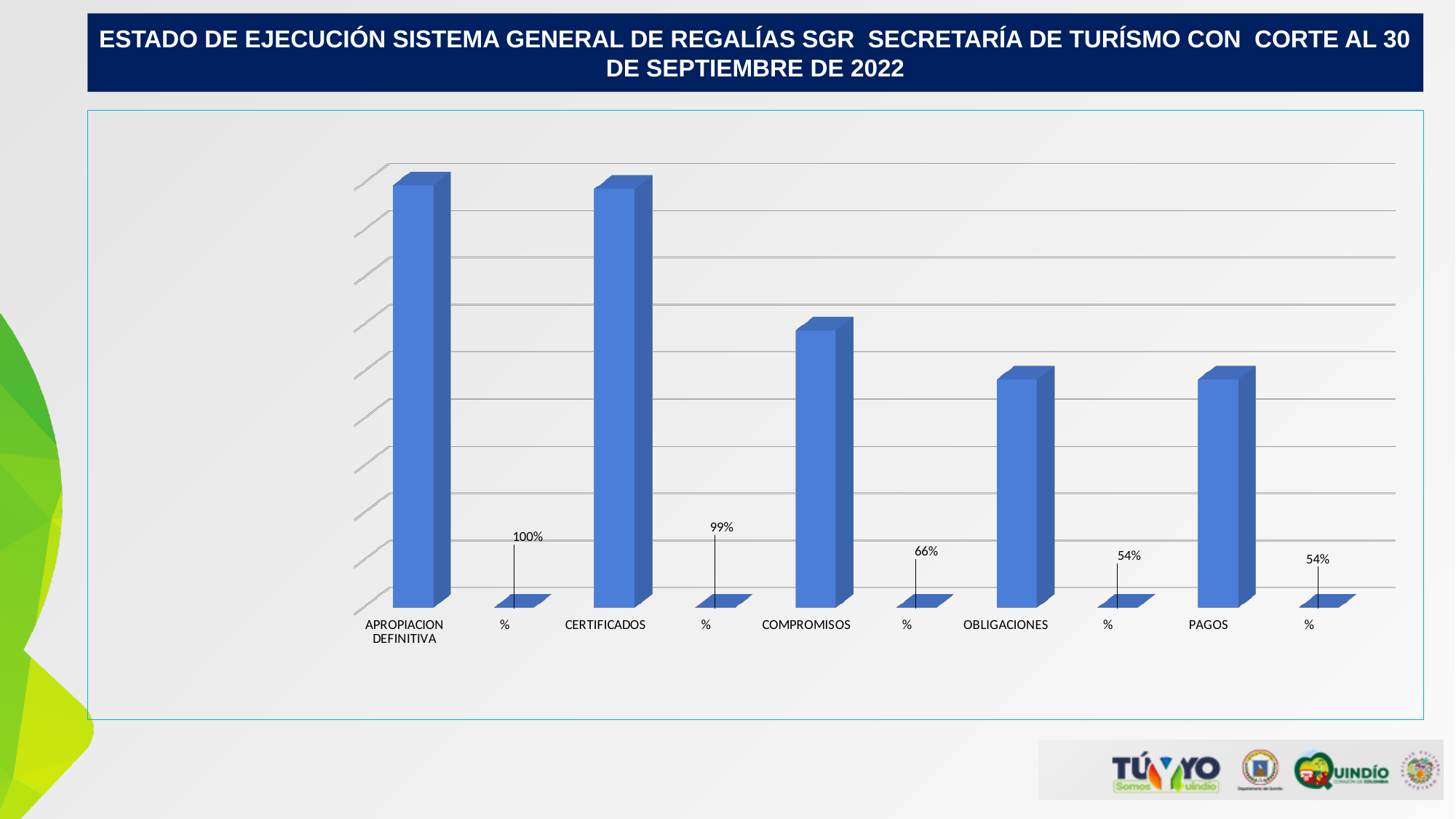
Which bar is taller, CERTIFICADOS or OBLIGACIONES? CERTIFICADOS Which bar is taller, APROPIACION DEFINITIVA or COMPROMISOS? APROPIACION DEFINITIVA What is the difference between the percentage for APROPIACION DEFINITIVA and the percentage for COMPROMISOS? 34% What percentage is shown next to OBLIGACIONES? 54% How many percentage values are printed as data labels on the chart? 5 What kind of chart is shown on the slide? Bar chart What percentage is shown next to APROPIACION DEFINITIVA? 100% Which category has the highest percentage label? APROPIACION DEFINITIVA What is the difference between the percentage for CERTIFICADOS and the percentage for PAGOS? 45% What percentage is shown next to CERTIFICADOS? 99% What percentage is shown next to PAGOS? 54% What percentage is shown next to COMPROMISOS? 66%